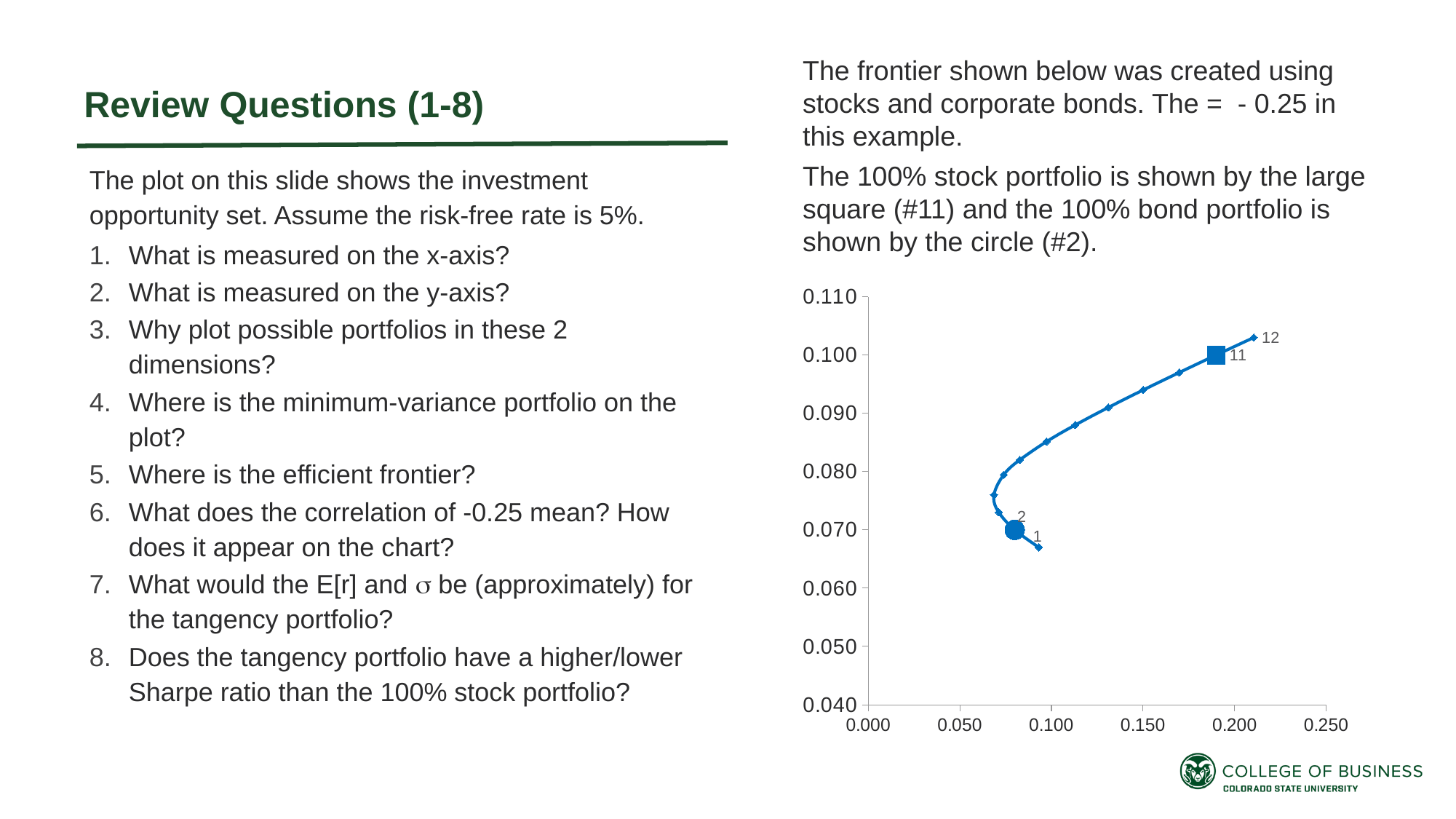
Which has the larger x-axis value, point 12 or point 1? 12 Is the x-axis value for point 2 greater or less than 0.100? less Which labeled point on the chart has the lowest y-axis value? 1 Is the y-axis value for point 1 greater or less than 0.070? less Which labeled point on the chart has the highest y-axis value? 12 What is the y-axis value of point 11 (the large square)? 0.100 What is the highest tick value shown on the y-axis? 0.110 What kind of chart is shown on the slide? scatter chart Is the y-axis value for point 12 greater or less than 0.100? greater Which has the higher y-axis value, point 11 or point 2? 11 Which labeled point is drawn as a large square? 11